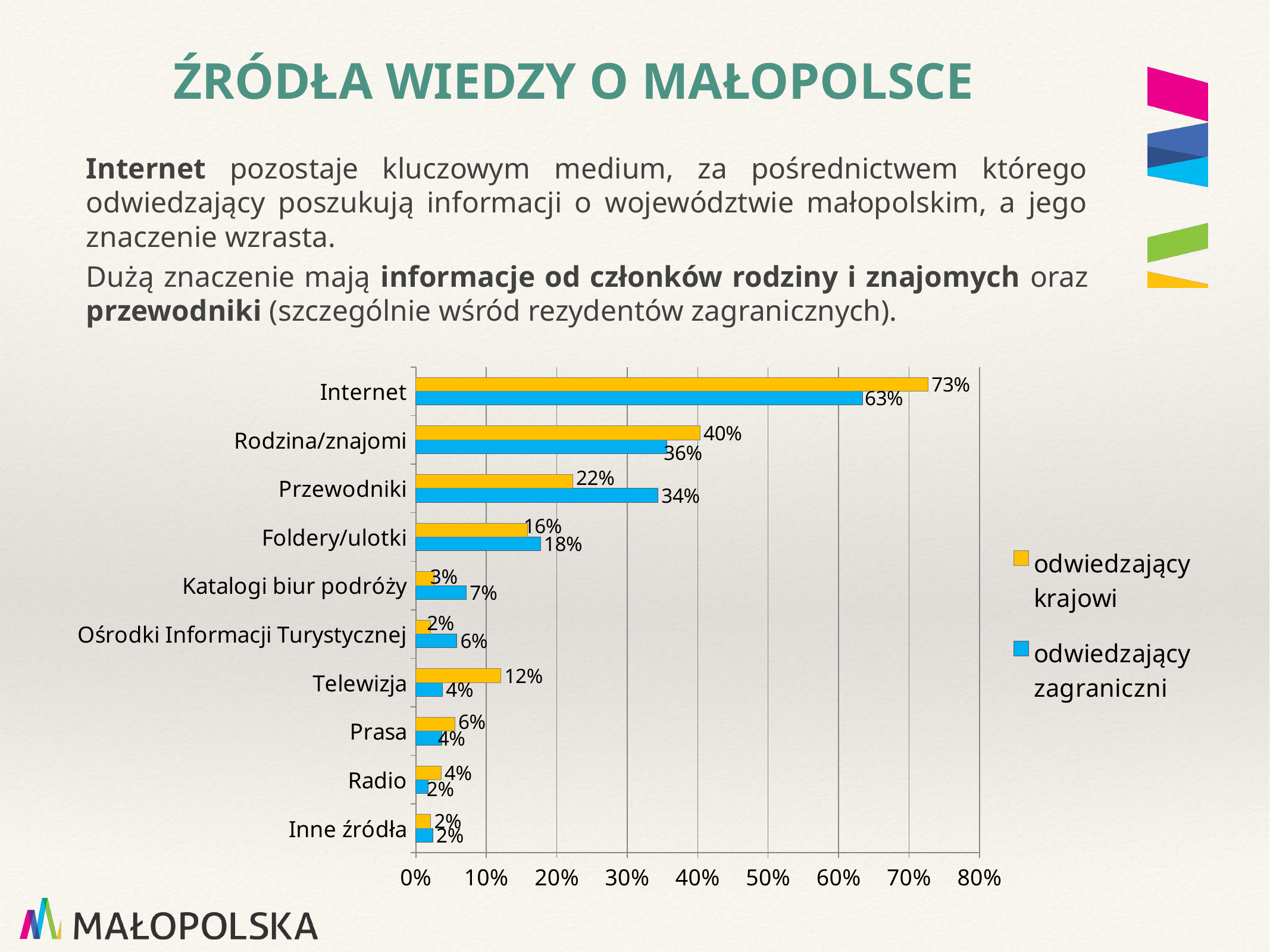
For Rodzina/znajomi, which series has the larger value: 'odwiedzający krajowi' or 'odwiedzający zagraniczni'? odwiedzający krajowi What is the difference between the 'odwiedzający krajowi' and 'odwiedzający zagraniczni' values for Internet? 10% What is the value for Przewodniki in the 'odwiedzający zagraniczni' series? 34% What is the value for Telewizja in the 'odwiedzający krajowi' series? 12% How many series does the legend list? 2 Which category has the highest value in the 'odwiedzający zagraniczni' series? Internet What is the difference between the 'odwiedzający zagraniczni' and 'odwiedzający krajowi' values for Przewodniki? 12% How many categories are shown on the chart? 10 Is the 'odwiedzający zagraniczni' value for Internet greater or less than 60%? greater What kind of chart is shown on the slide? bar chart What is the value for Internet in the 'odwiedzający krajowi' series? 73%